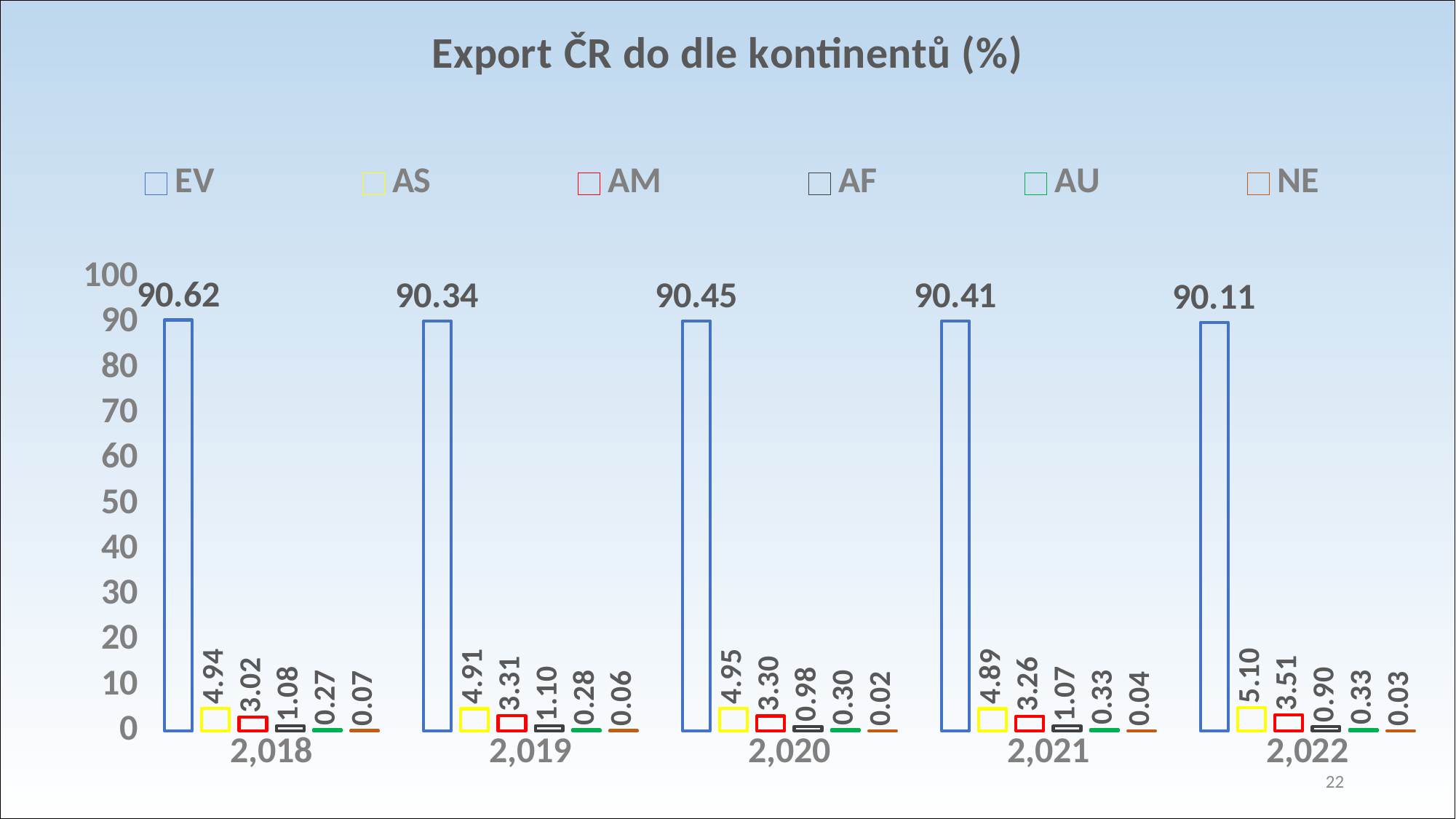
What is the title of the chart? Export ČR do dle kontinentů (%) What is the value for AM in 2019? 3.31 In which year is the EV value highest? 2,018 What is the value for NE in 2020? 0.02 How many years are shown on the x axis? 5 What is the value for AS in 2022? 5.10 What is the value for EV in 2018? 90.62 What kind of chart is shown on the slide? bar chart How many series does the legend list? 6 In which year is the EV value lowest? 2,022 What is the difference between the EV value in 2018 and the EV value in 2022? 0.51 Which is larger, the AS value in 2022 or the AS value in 2018? AS in 2022